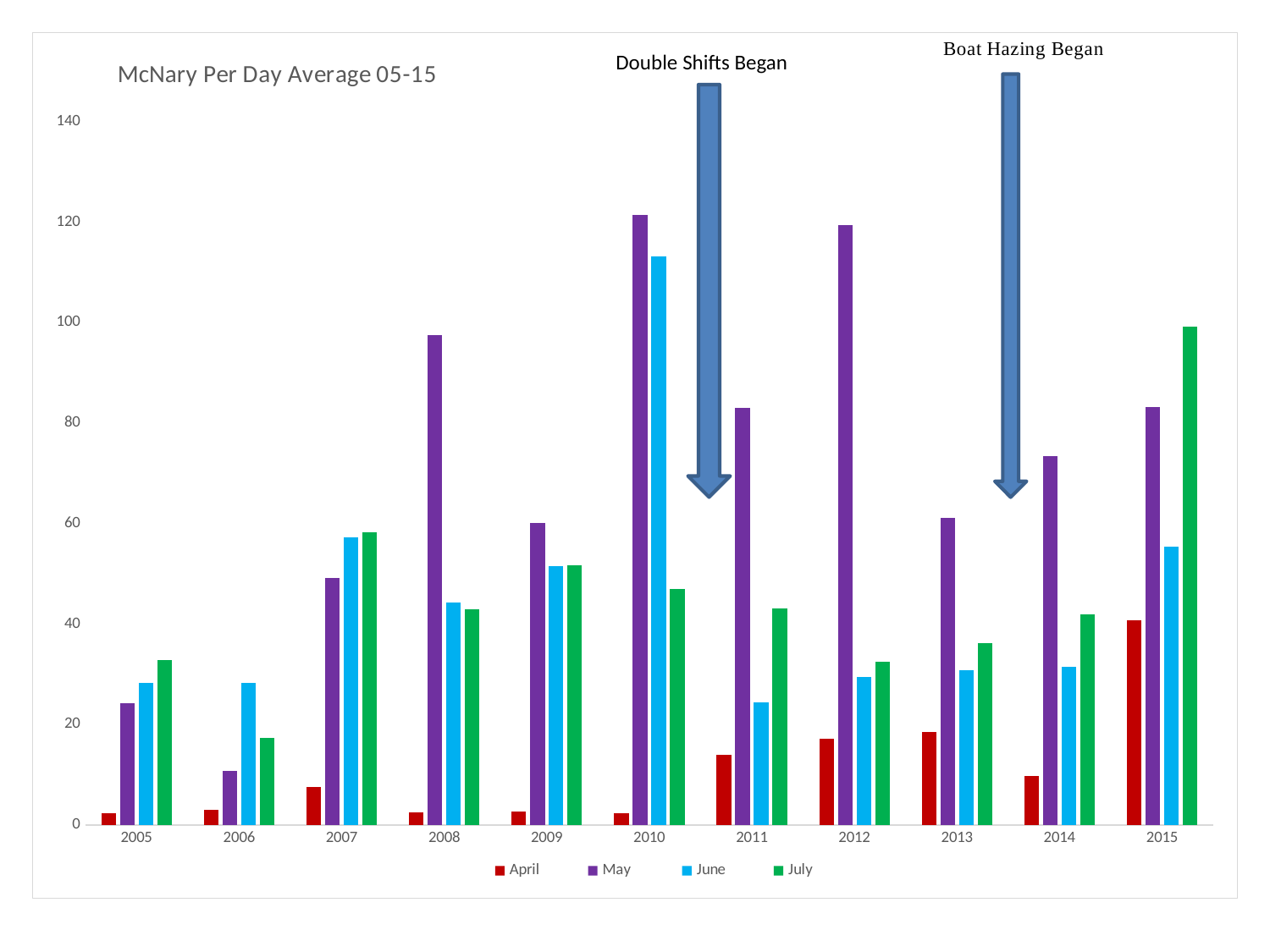
Is the June value for 2010 greater or less than 100? greater Which year has the highest July value? 2015 How many series does the legend list? 4 In 2006, which is larger, the May value or the June value? June Do the May values rise or fall from 2013 to 2015? rise How many years are shown on the x axis? 11 Is the May value for 2010 greater or less than 100? greater What kind of chart is shown on the slide? bar chart Is the July value for 2015 greater or less than 80? greater Which year has the highest April value? 2015 In 2008, which is larger, the May value or the June value? May What is the title of the chart? McNary Per Day Average 05-15